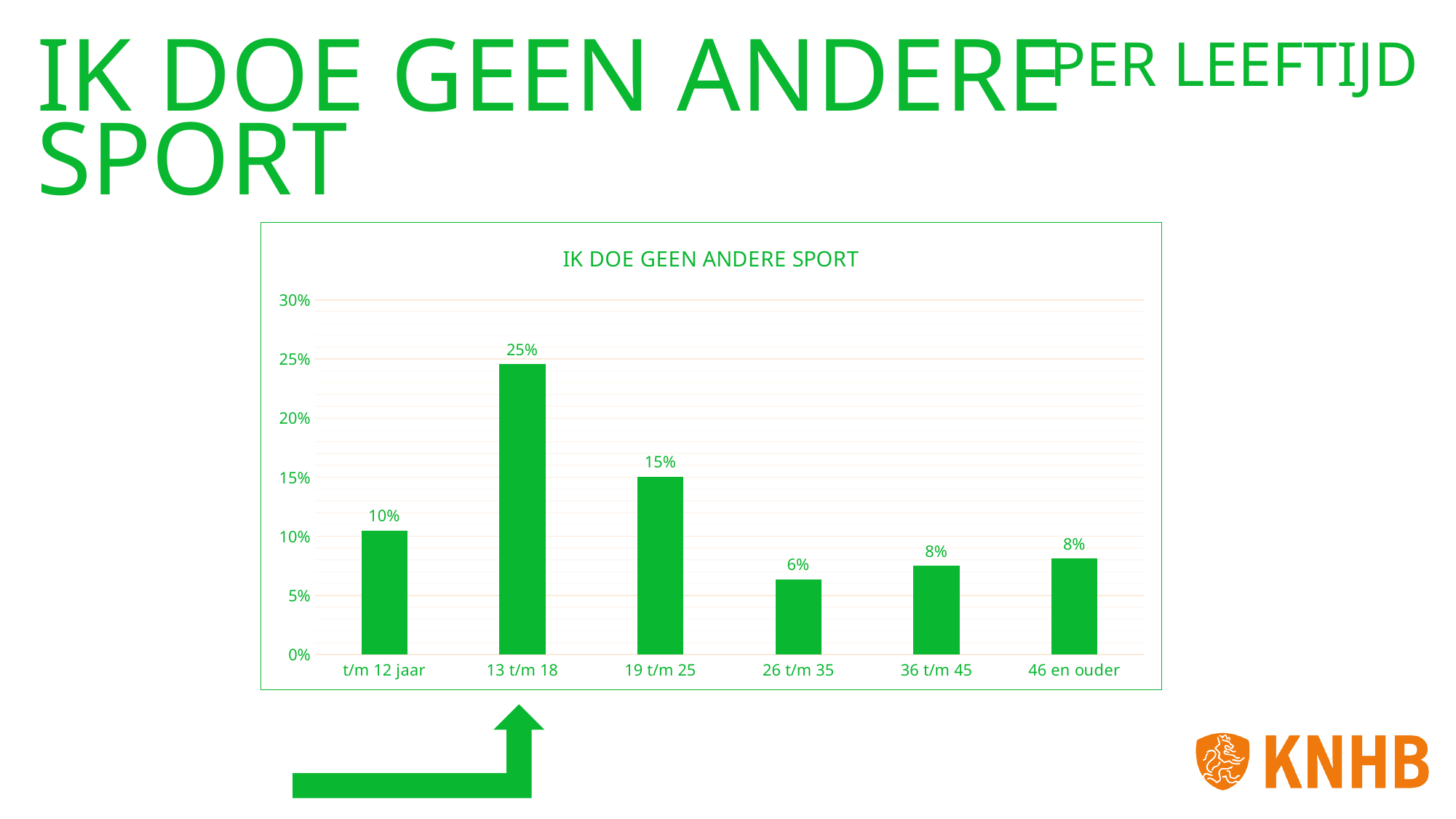
What is the value for the t/m 12 jaar age group? 10% Which is larger, the value for t/m 12 jaar or the value for 36 t/m 45? t/m 12 jaar What kind of chart is shown on the slide? bar chart How many age groups are shown on the x axis? 6 What is the value for the 26 t/m 35 age group? 6% What is the value for the 13 t/m 18 age group? 25% What is the title of the chart? IK DOE GEEN ANDERE SPORT Which age group has the lowest value? 26 t/m 35 What is the difference between the values for 13 t/m 18 and 19 t/m 25? 10% Which age group has the highest value? 13 t/m 18 Is the value for 19 t/m 25 greater or less than 20%? less Do the values rise or fall from 13 t/m 18 to 26 t/m 35? fall